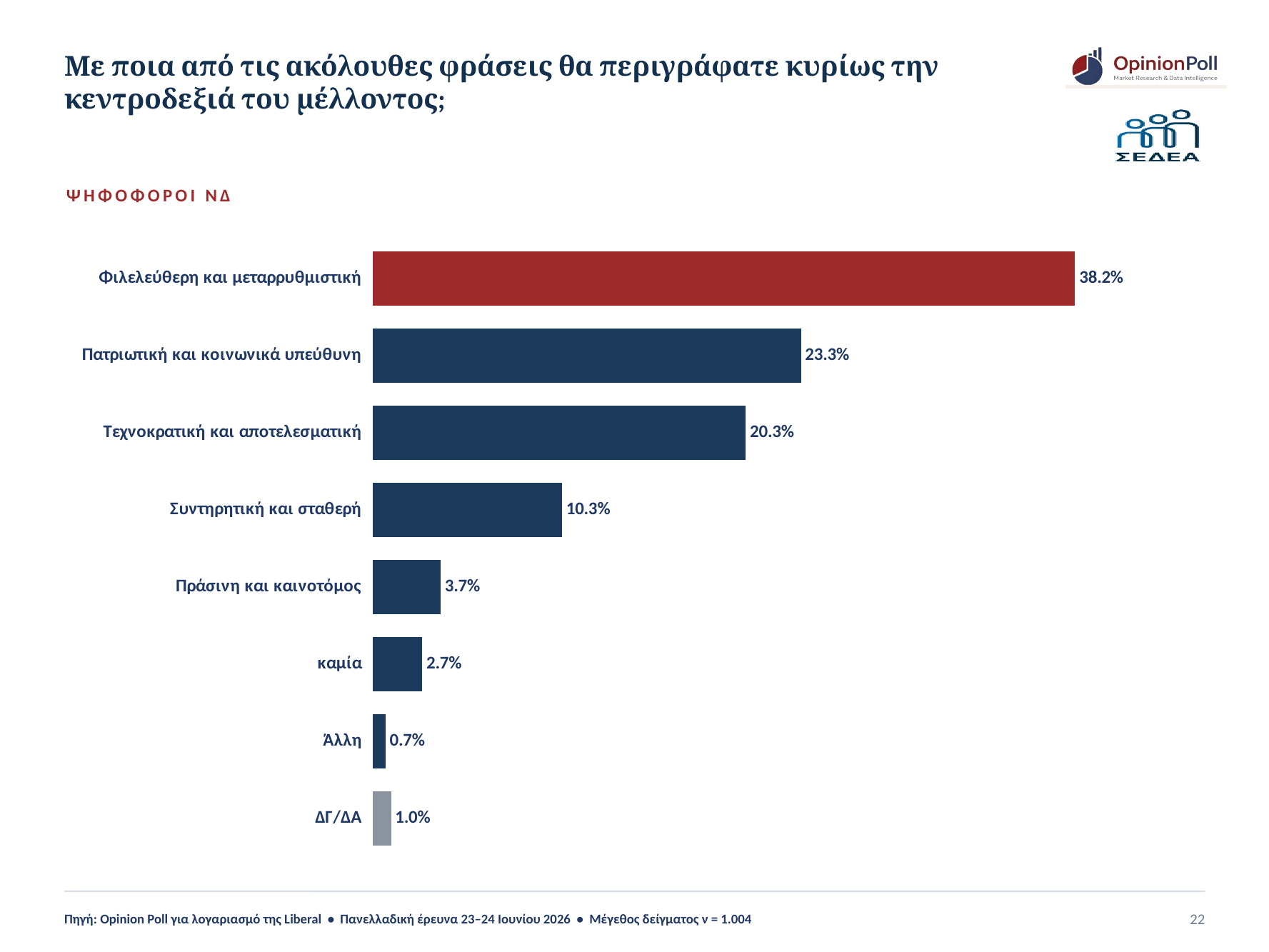
Which is larger: Πράσινη και καινοτόμος or καμία? Πράσινη και καινοτόμος How many categories are shown in the chart? 8 What is the value for Πατριωτική και κοινωνικά υπεύθυνη? 23.3% What is the difference between Τεχνοκρατική και αποτελεσματική and Συντηρητική και σταθερή? 10.0% What is the value for Φιλελεύθερη και μεταρρυθμιστική? 38.2% What is the value for ΔΓ/ΔΑ? 1.0% Which category has the lowest value? Άλλη What is the value for Συντηρητική και σταθερή? 10.3% Which bar is coloured red rather than dark blue? Φιλελεύθερη και μεταρρυθμιστική Which category has the highest value? Φιλελεύθερη και μεταρρυθμιστική What kind of chart is shown on the slide? Bar chart What is the difference between Φιλελεύθερη και μεταρρυθμιστική and Πατριωτική και κοινωνικά υπεύθυνη? 14.9%